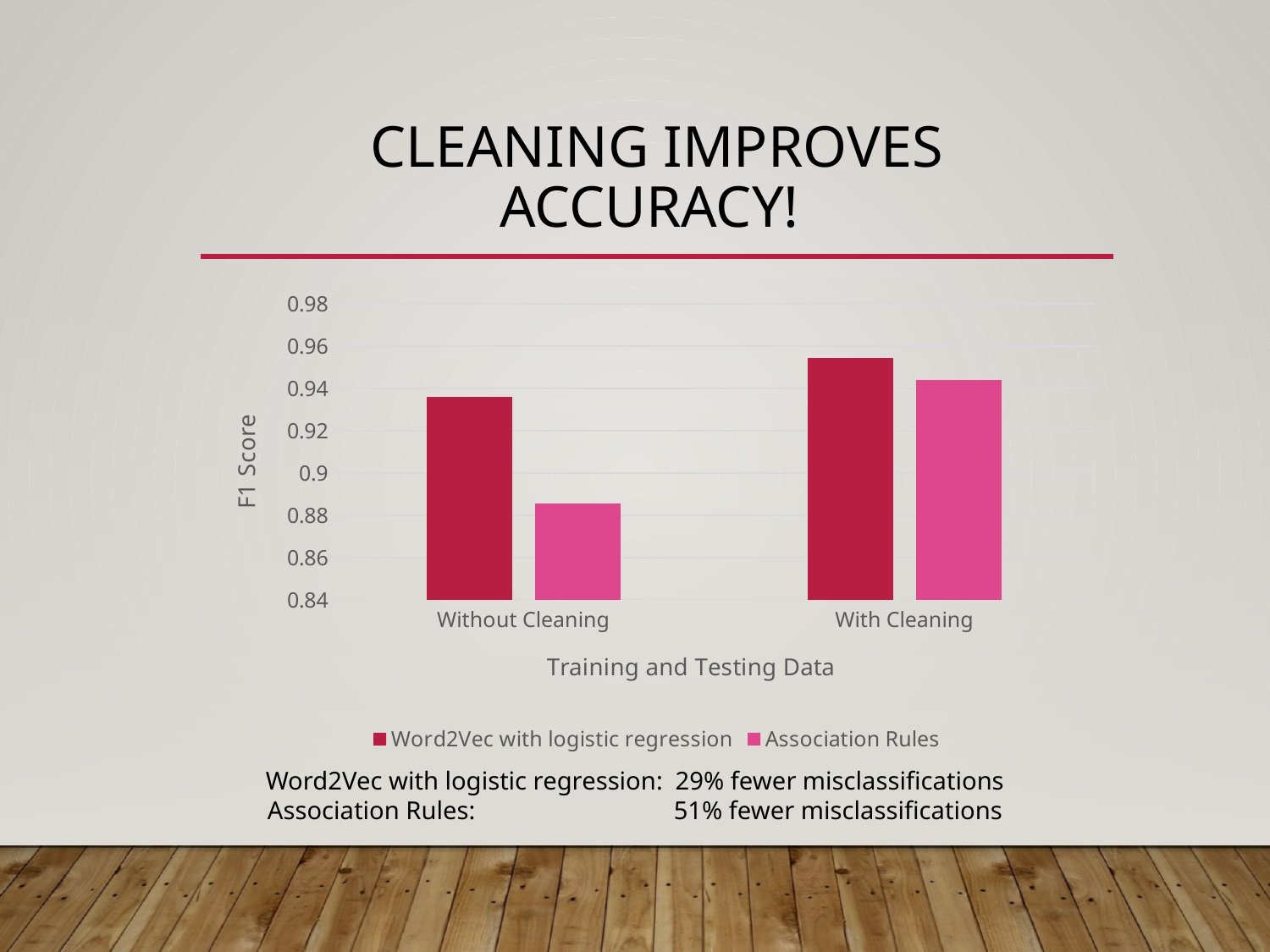
Does the F1 Score for Association Rules rise or fall from Without Cleaning to With Cleaning? rise Which bar has the highest F1 Score? Word2Vec with logistic regression, With Cleaning How many categories are shown on the x axis? 2 Is the F1 Score for Word2Vec with logistic regression With Cleaning greater or less than 0.94? greater Without Cleaning, which series has the higher F1 Score: Word2Vec with logistic regression or Association Rules? Word2Vec with logistic regression Is the F1 Score for Word2Vec with logistic regression Without Cleaning greater or less than 0.92? greater Which bar has the lowest F1 Score? Association Rules, Without Cleaning Is the F1 Score for Association Rules With Cleaning greater or less than 0.92? greater What is the title of the y axis? F1 Score What kind of chart is shown on the slide? bar chart How many series does the legend list? 2